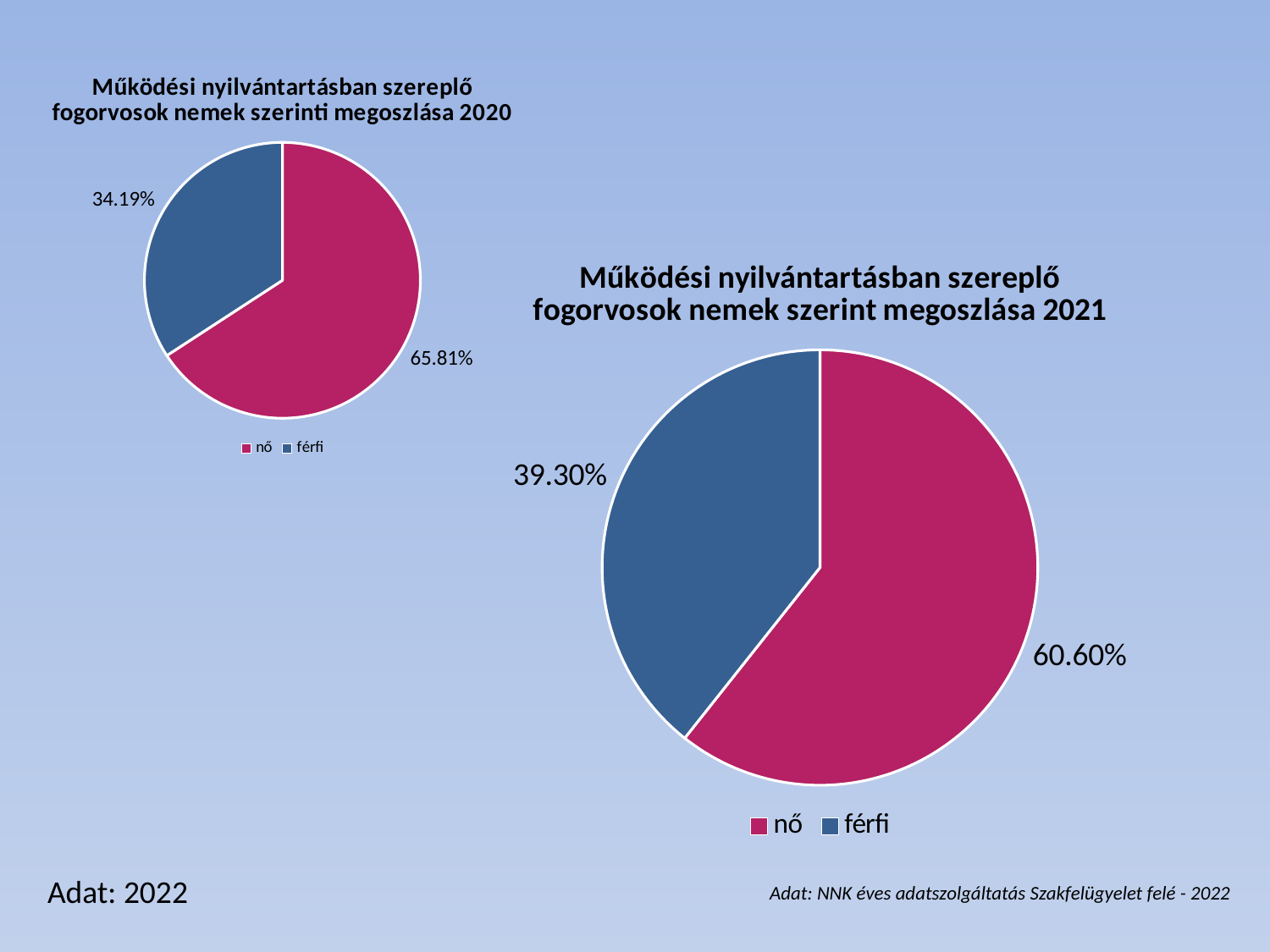
In the 2021 chart (right), which category has the larger slice? nő In the 2021 chart (right), what is the difference between the 'nő' and 'férfi' shares? 21.30% How many entries does the legend of the 2021 chart (right) list? 2 In the 2021 chart (right), what share of dentists are 'nő'? 60.60% In the 2020 chart (top left), what is the difference between the 'nő' and 'férfi' shares? 31.62% In the 2020 chart (top left), what colour is the 'nő' slice? red What type of chart is used in the 2021 chart (right)? pie chart In the 2021 chart (right), what share of dentists are 'férfi'? 39.30% In the 2020 chart (top left), which category has the smaller slice? férfi Is the 'férfi' share larger in the 2020 chart or the 2021 chart? 2021 In the 2020 chart (top left), what share of dentists are 'férfi'? 34.19% In the 2020 chart (top left), what share of dentists are 'nő'? 65.81%